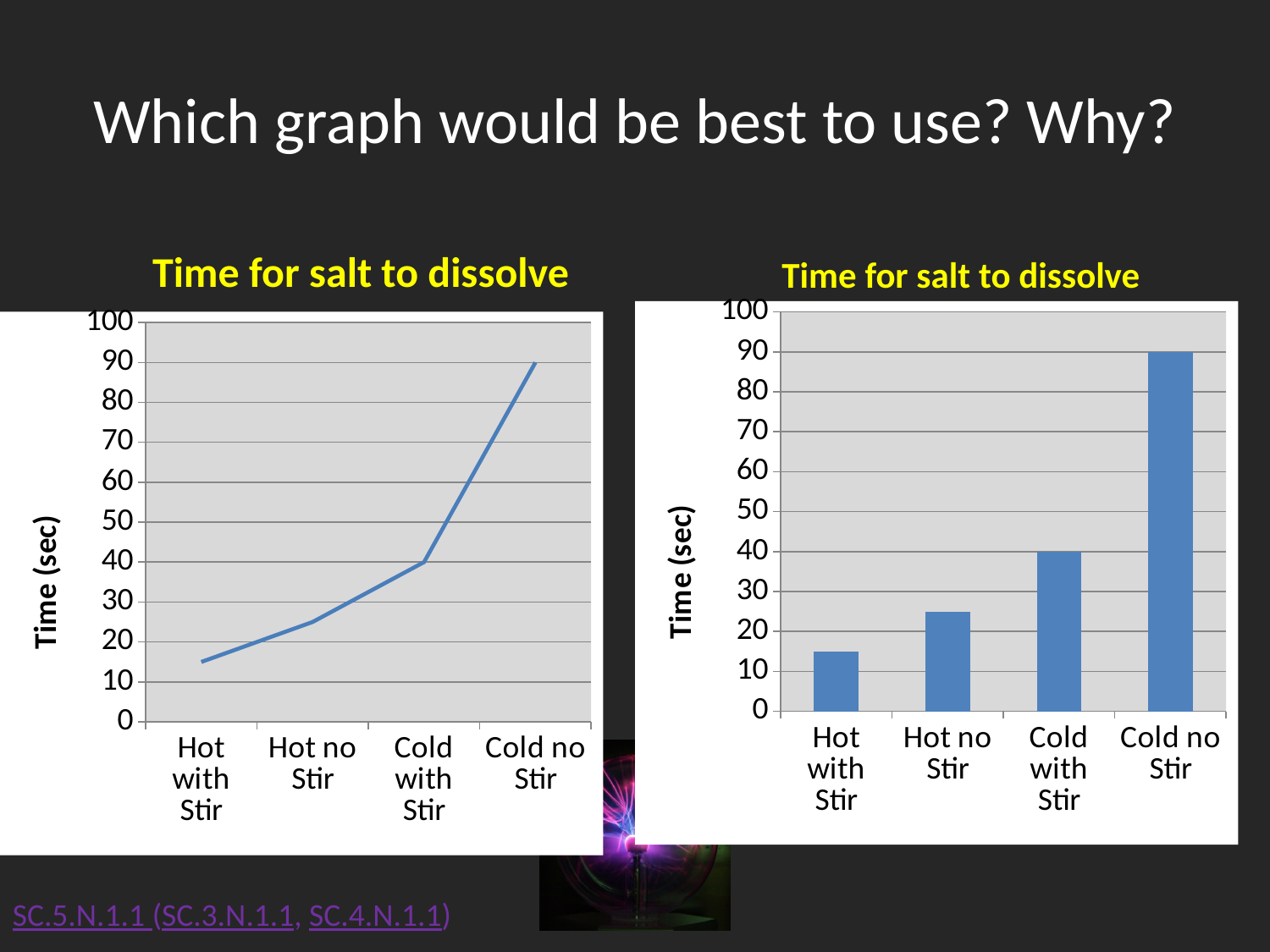
On the right chart, which category has the highest value? Cold no Stir On the left chart, which category has the lowest value? Hot with Stir On the right chart, which is larger, the value for Hot no Stir or the value for Cold with Stir? Cold with Stir On the left chart, is the value for Hot with Stir greater or less than 20? less On the left chart, how many categories are shown on the x axis? 4 On the right chart, what kind of chart is it? bar chart On the right chart, what is the value for Cold no Stir? 90 On the left chart, what kind of chart is it? line chart On the left chart, what is the value for Cold with Stir? 40 On the right chart, is the value for Hot no Stir greater or less than 20? greater On the left chart, do the values rise or fall from Hot with Stir to Cold no Stir? rise On the right chart, what is the difference between the values for Cold no Stir and Cold with Stir? 50